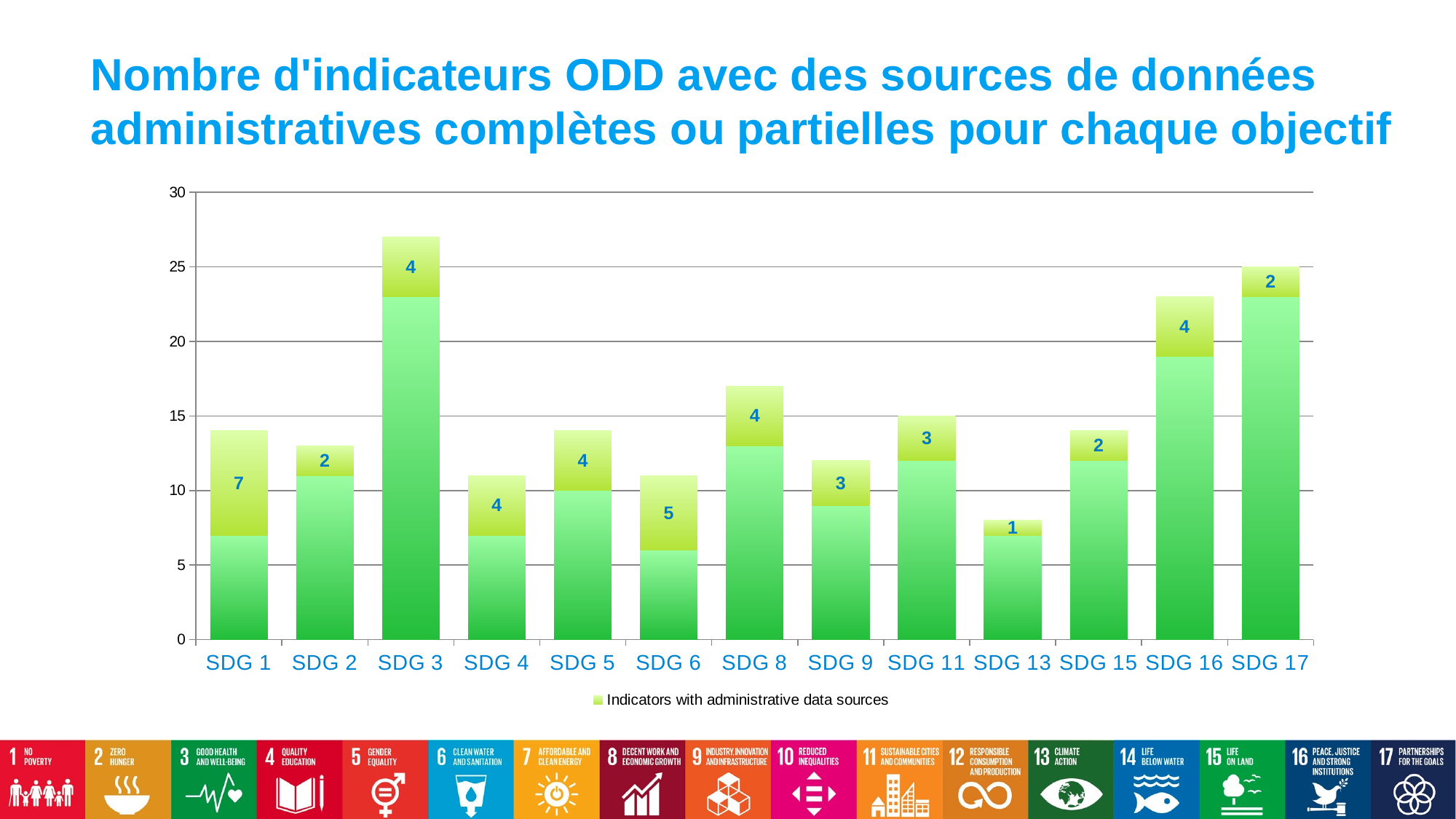
Which SDG has the lowest labelled value on its bar? SDG 13 Which SDG has the tallest bar overall? SDG 3 What is the labelled value shown on the SDG 1 bar? 7 Which SDG has the highest labelled value on its bar? SDG 1 What is the labelled value shown on the SDG 13 bar? 1 Is the total height of the SDG 3 bar greater or less than 25? greater How many SDG categories are shown on the x axis? 13 What is the difference between the labelled values for SDG 1 and SDG 13? 6 Which has the larger labelled value, SDG 6 or SDG 9? SDG 6 What kind of chart is shown on the slide? bar chart Which SDG has the shortest bar overall? SDG 13 What is the labelled value shown on the SDG 6 bar? 5